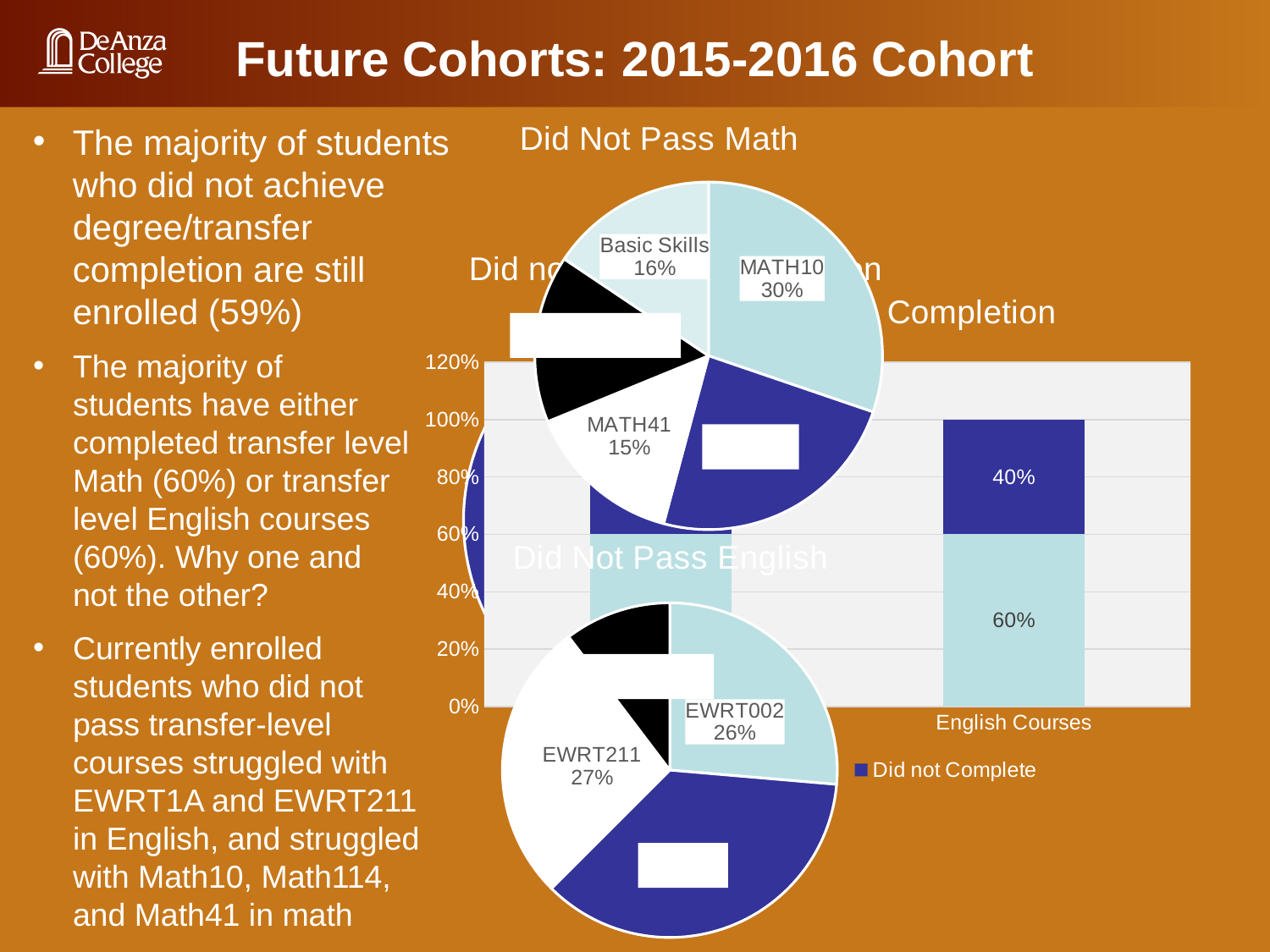
In the Did Not Pass Math pie chart, what is the difference in percentage points between MATH10 and Basic Skills? 14 percentage points In the Did Not Pass English pie chart, what percentage is shown for EWRT211? 27% In the Did Not Pass Math pie chart, what percentage is shown for Basic Skills? 16% In the Did Not Pass Math pie chart, what percentage is shown for MATH10? 30% In the Did Not Pass Math pie chart, which slice is larger, MATH10 or MATH41? MATH10 What kind of chart is the Did Not Pass Math chart? Pie chart What kind of chart is the chart on the right with the English Courses category? Bar chart In the Did Not Pass Math pie chart, what percentage is shown for MATH41? 15% In the Did Not Pass English pie chart, what percentage is shown for EWRT002? 26% In the bar chart on the right, what is the Did not Complete value for English Courses? 40% In the Did Not Pass English pie chart, what is the difference in percentage points between EWRT211 and EWRT002? 1 percentage point In the bar chart on the right, what is the total of the two segments of the English Courses bar? 100%